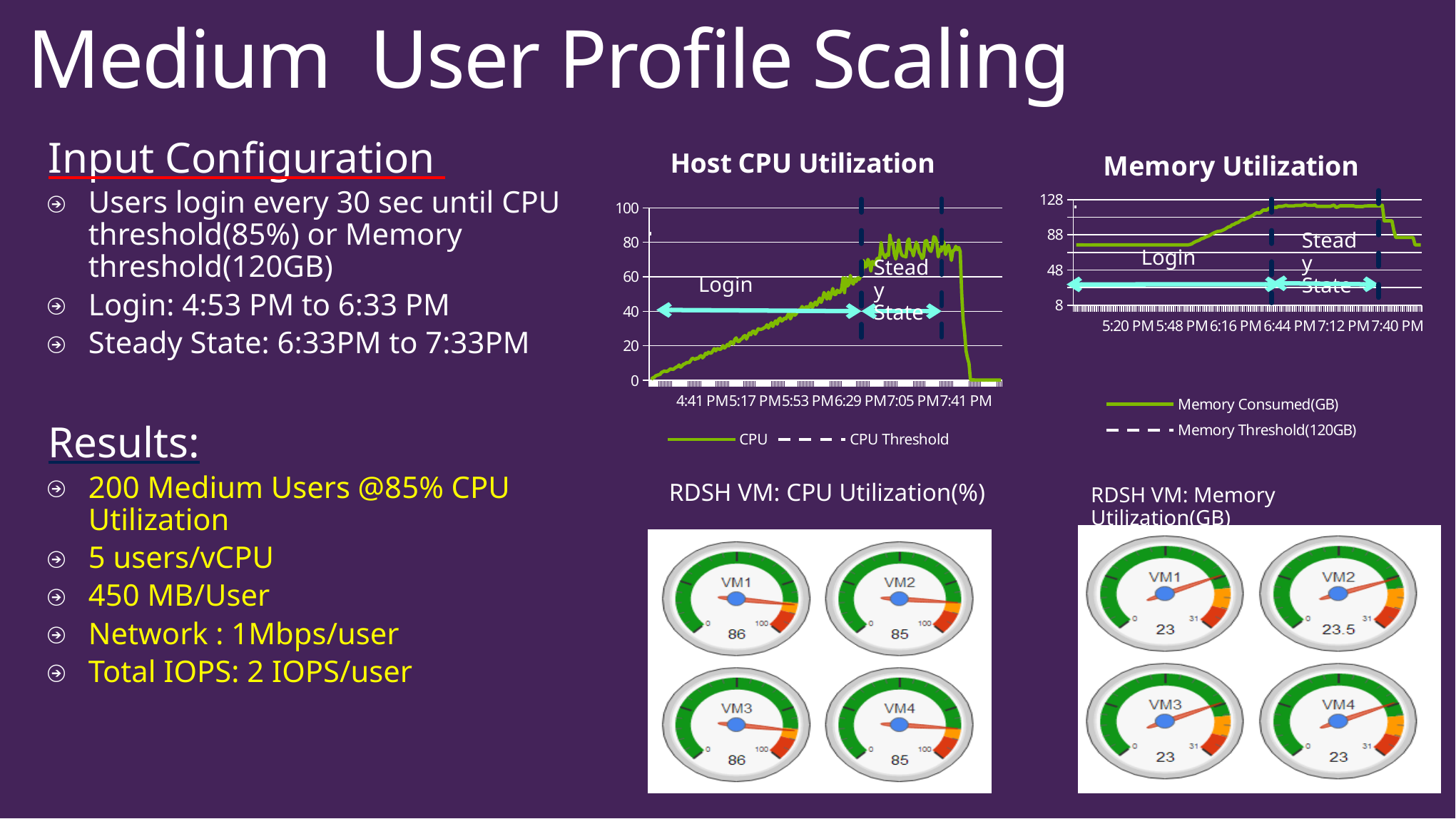
In the RDSH VM: CPU Utilization(%) gauges, what is the difference between VM1 and VM2? 1 In the Host CPU Utilization chart, is the CPU value at 5:17 PM greater or less than 40? less In the RDSH VM: CPU Utilization(%) gauges, what is the value for VM1? 86 In the RDSH VM: Memory Utilization(GB) gauges, which VM has the highest value? VM2 In the Host CPU Utilization chart, does the CPU line rise or fall between 4:41 PM and 6:29 PM? rise In the Memory Utilization chart, is the memory consumed at 7:12 PM greater or less than 88? greater What are the two legend entries of the Memory Utilization chart? Memory Consumed(GB) and Memory Threshold(120GB) How many series does the legend of the Host CPU Utilization chart list? 2 How many time labels are shown on the x axis of the Memory Utilization chart? 6 What kind of chart is the Host CPU Utilization chart? line chart In the Memory Utilization chart, is the memory consumed at 5:20 PM greater or less than 48? greater In the RDSH VM: Memory Utilization(GB) gauges, what is the value for VM2? 23.5